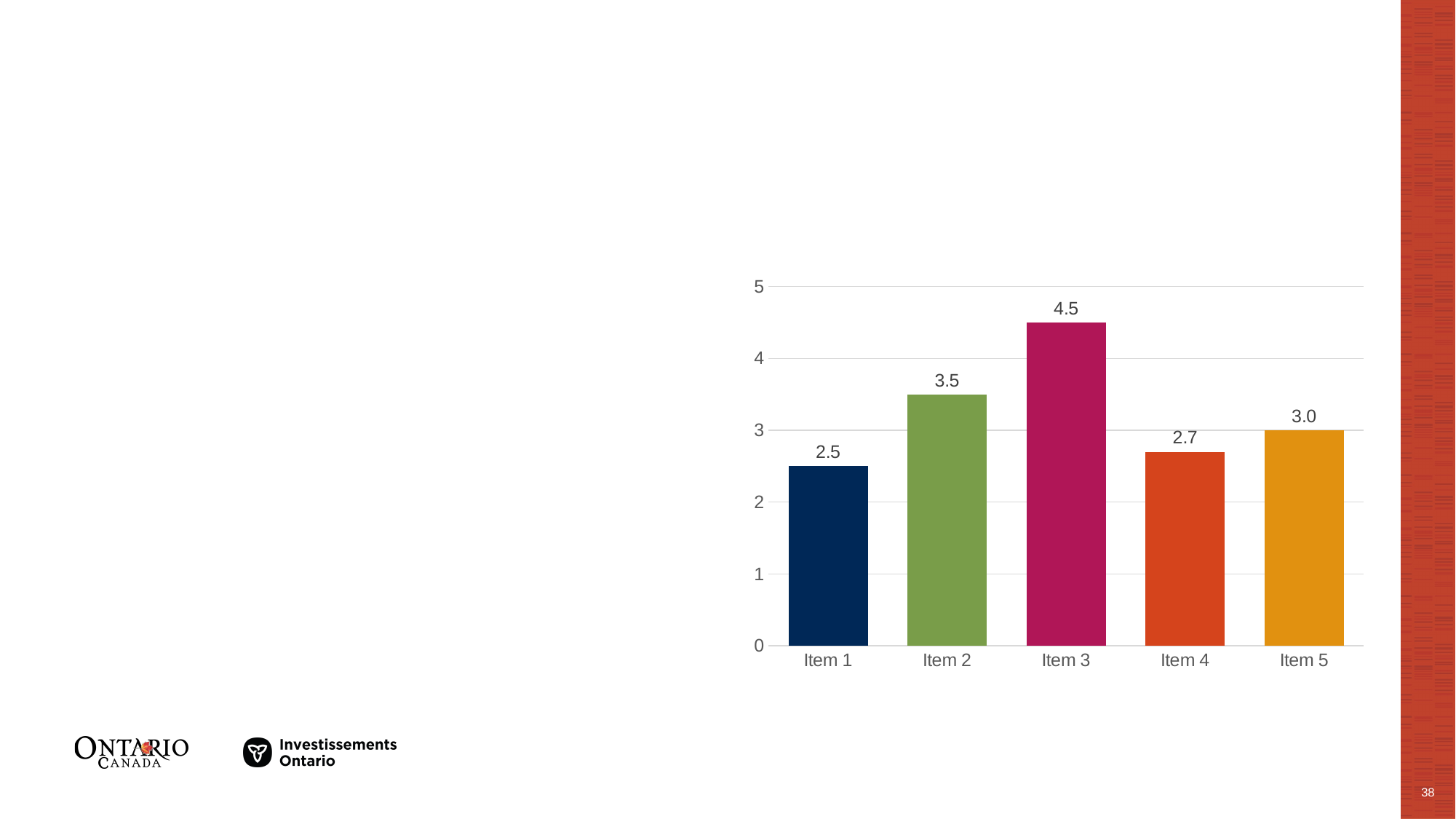
What colour is the bar for Item 3? magenta Is the value for Item 4 greater or less than 3? less What is the value for Item 1? 2.5 What is the value for Item 5? 3.0 What kind of chart is shown on the slide? bar chart What is the difference between the values for Item 4 and Item 1? 0.2 Which item has the lowest value? Item 1 How many items are shown on the x axis? 5 What is the difference between the values for Item 3 and Item 2? 1.0 Which item has the highest value? Item 3 What is the value for Item 3? 4.5 Which is larger, the value for Item 2 or the value for Item 5? Item 2